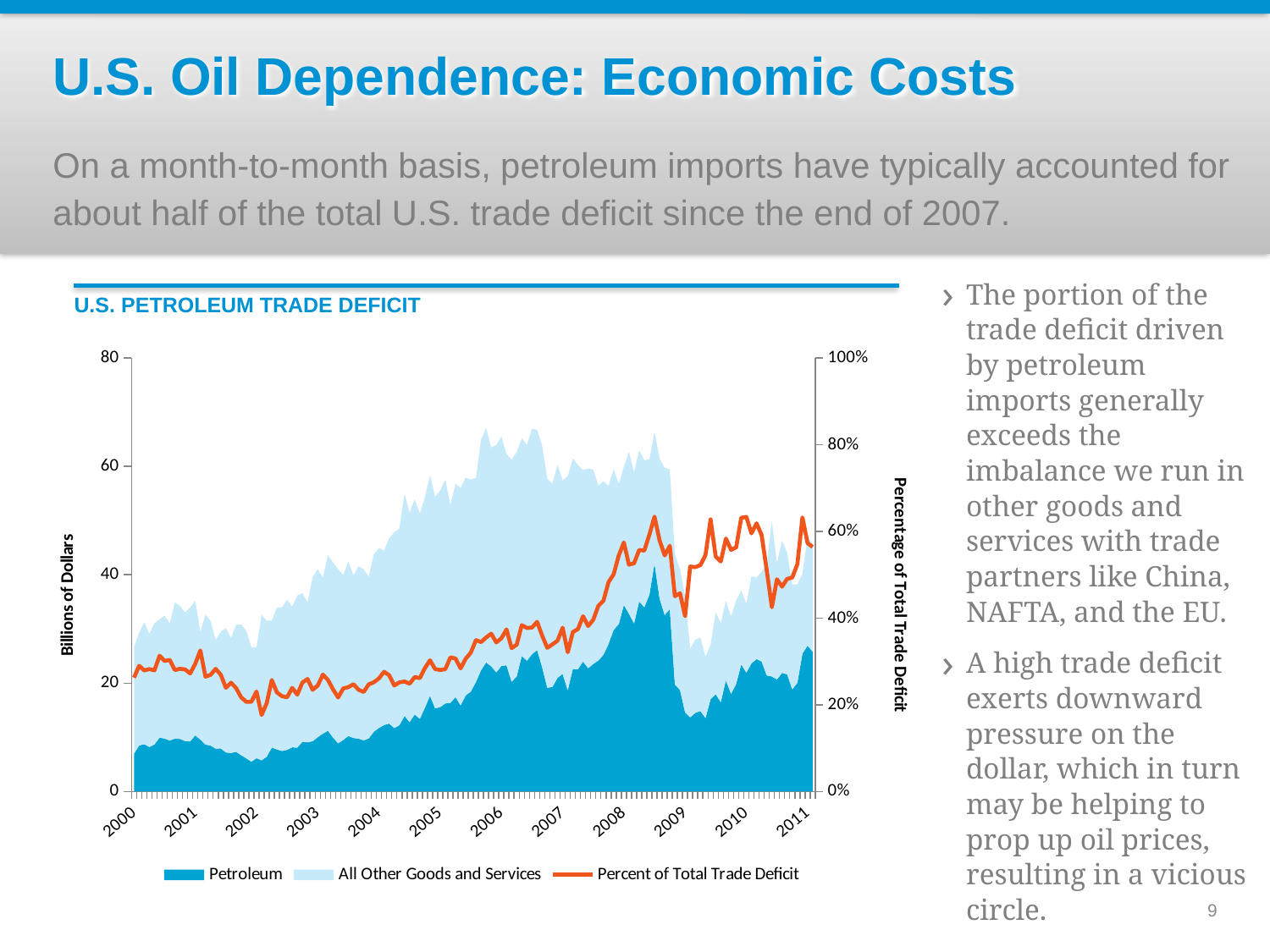
What kind of chart is shown under the title "U.S. PETROLEUM TRADE DEFICIT"? A stacked area chart with a line series Is the Percent of Total Trade Deficit line at the start of 2000 greater or less than 40%? less Does the Petroleum area rise or fall sharply at the end of 2008 into 2009? fall Is the Percent of Total Trade Deficit line in 2002 greater or less than 30%? less Is the top of the stacked area (Petroleum plus All Other Goods and Services) at its 2006 peak greater or less than 60 billion dollars? greater How many series does the legend of the U.S. Petroleum Trade Deficit chart list? 3 Does the Percent of Total Trade Deficit line generally rise or fall between 2000 and 2008? rise What is the title of the left vertical axis of the chart? Billions of Dollars What are the three series listed in the legend of the chart? Petroleum, All Other Goods and Services, Percent of Total Trade Deficit How many year labels are shown along the x axis of the chart? 12